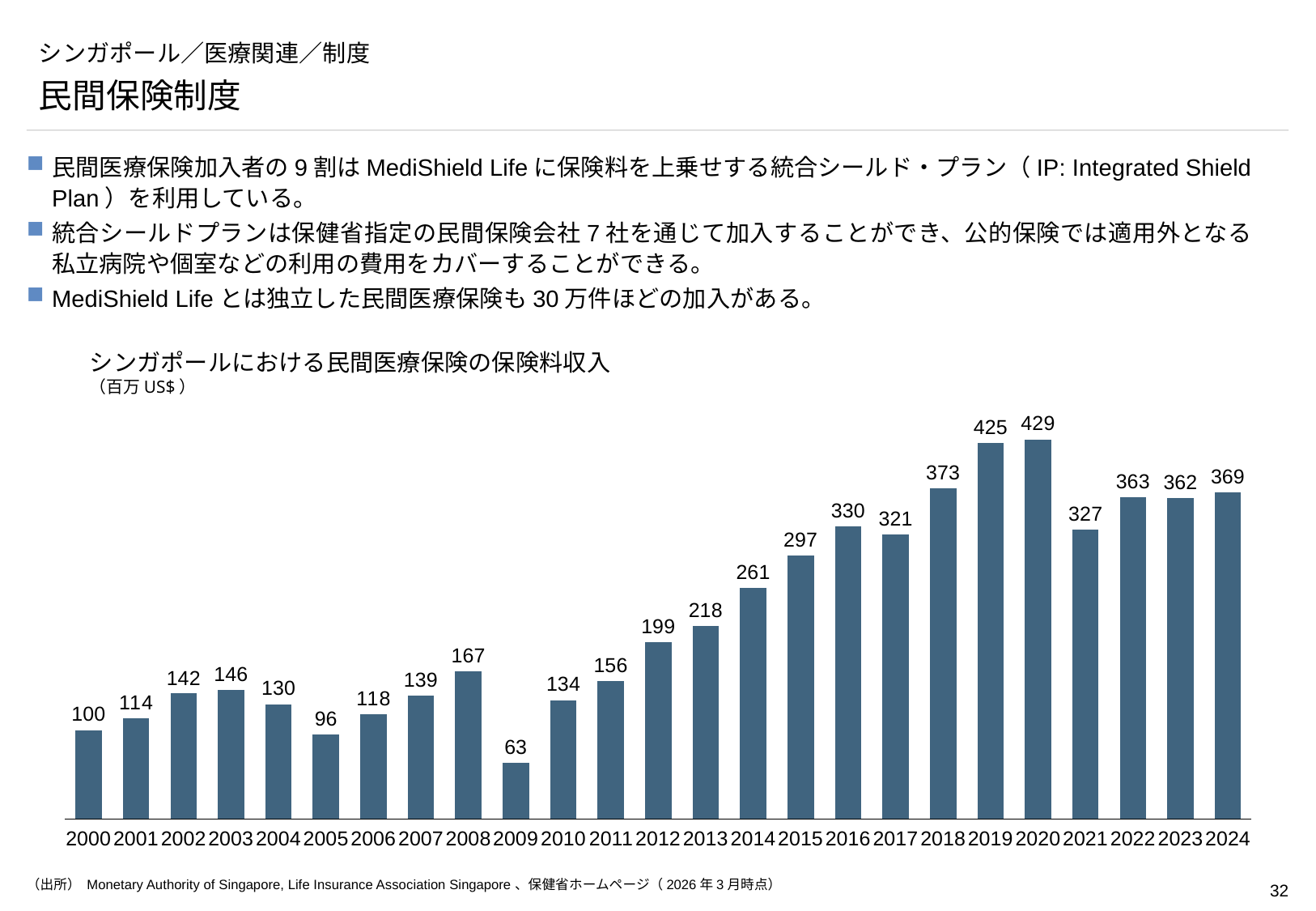
What kind of chart is this? bar chart Do the values rise or fall from 2009 to 2020? rise Which year has the lowest value? 2009 Which is larger, the value for 2018 or the value for 2021? 2018 What is the value for 2020? 429 What unit is shown under the chart title? 百万US$ What is the value for 2009? 63 Which year has the highest value? 2020 How many years are shown on the x axis? 25 What is the value for 2015? 297 What is the difference between the values for 2024 and 2000? 269 What is the difference between the values for 2020 and 2019? 4